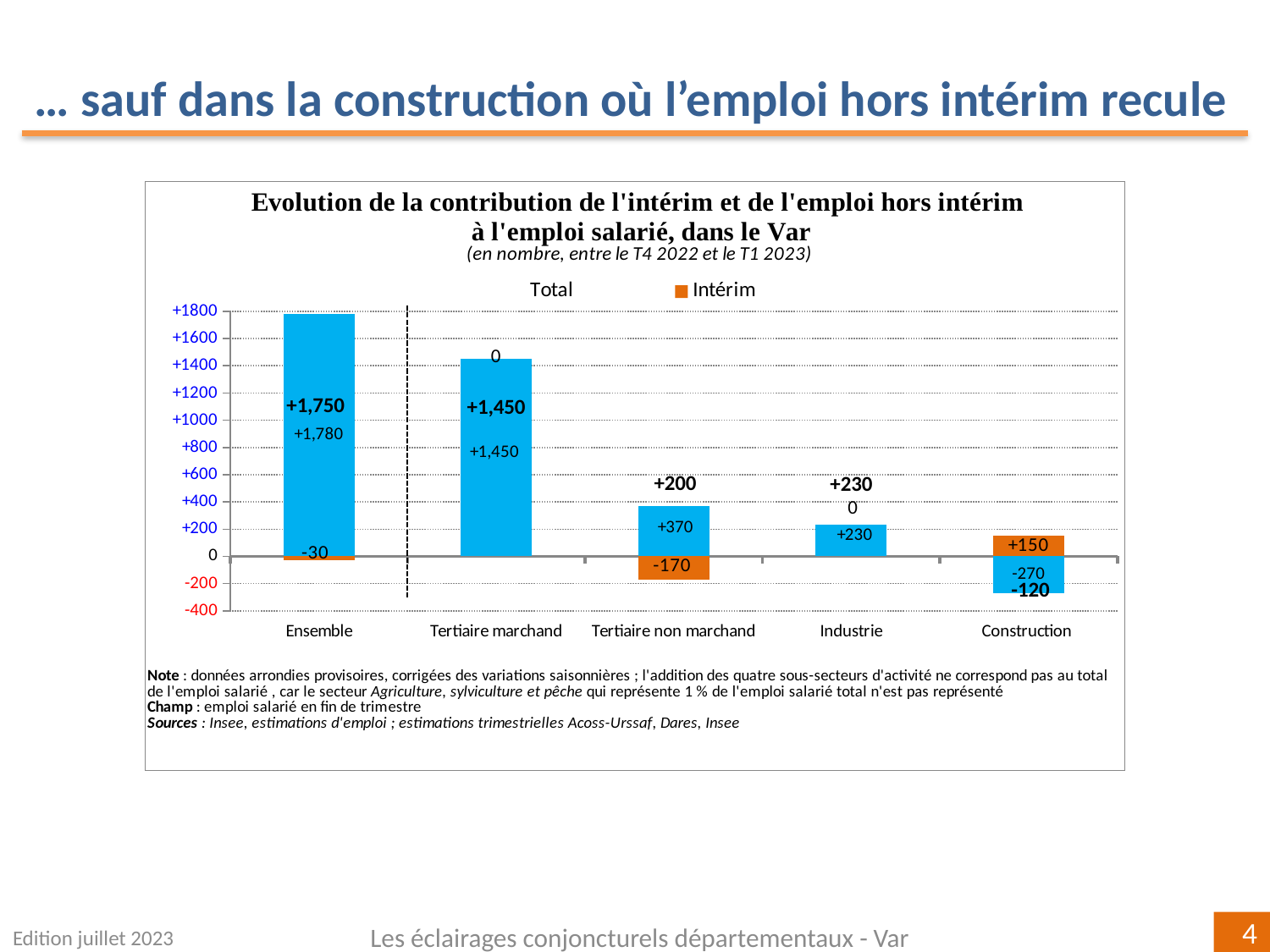
What is the difference between the total for Tertiaire marchand and the total for Industrie? 1,220 What is the Intérim value for Construction? +150 How many categories are shown on the x axis? 5 What is the Intérim value for Tertiaire non marchand? -170 What is the total value shown for Tertiaire non marchand? +200 What kind of chart is shown on the slide? Bar chart What is the value of the blue (hors intérim) bar for Construction? -270 Which has the larger total value, Tertiaire non marchand or Industrie? Industrie What is the Intérim value for Tertiaire marchand? 0 What is the total value shown for Ensemble? +1,750 Which category has the highest total value? Ensemble Which category has the lowest total value? Construction